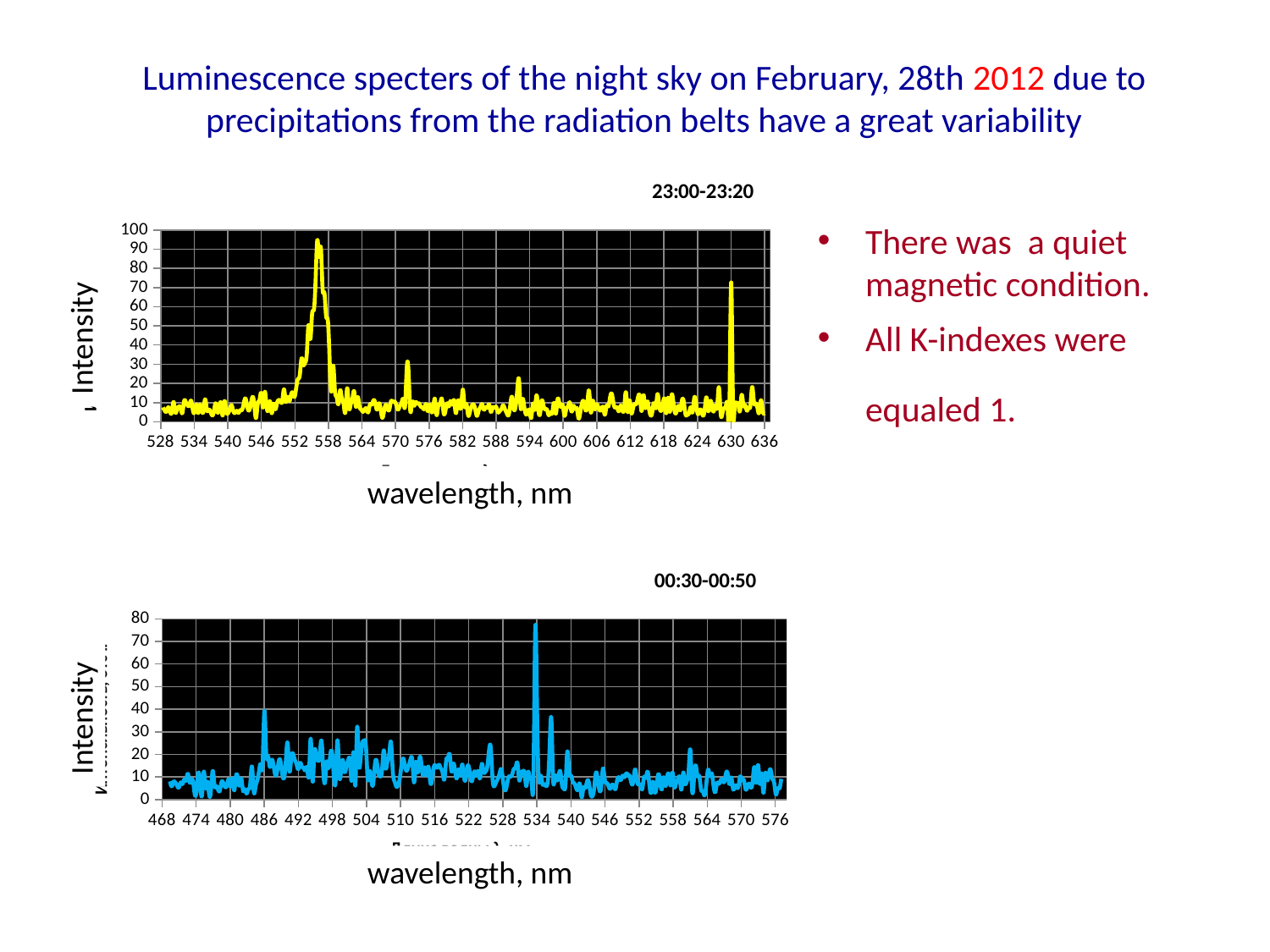
In the top chart (23:00-23:20), is the tallest peak, near 557 nm, greater or less than 80? greater In the bottom chart (00:30-00:50), is the tallest peak, near 534 nm, greater or less than 70? greater What kind of chart is the bottom chart titled 00:30-00:50? line chart In the top chart (23:00-23:20), is the sharp peak near 630 nm greater or less than 60? greater What kind of chart is the top chart titled 23:00-23:20? line chart What colour is the line in the bottom chart (00:30-00:50)? blue In the bottom chart (00:30-00:50), which peak is higher: the one near 486 nm or the one near 534 nm? the one near 534 nm In the top chart (23:00-23:20), which peak is higher: the one near 557 nm or the one near 630 nm? the one near 557 nm What is the highest value shown on the y axis of the top chart (23:00-23:20)? 100